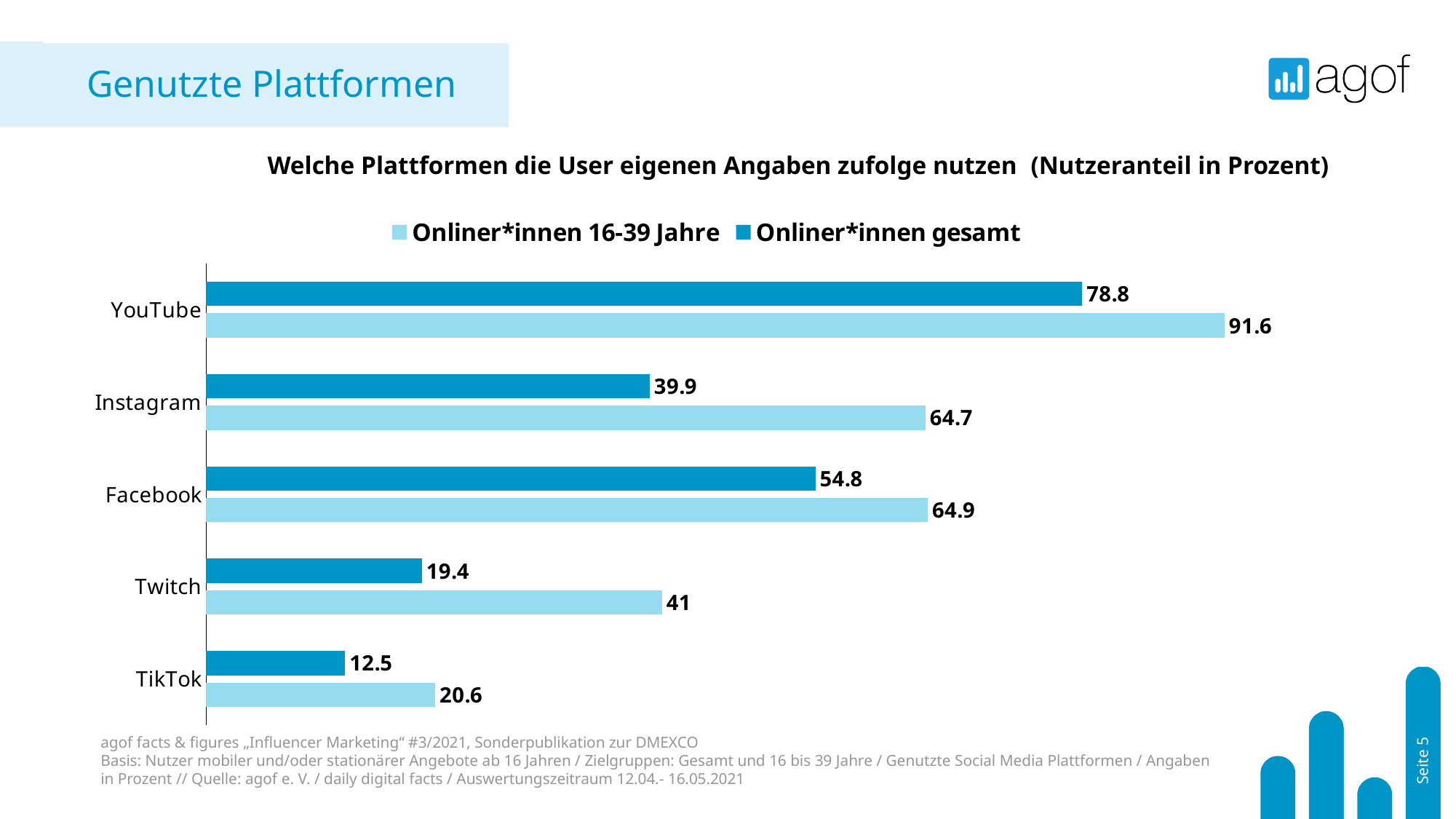
What kind of chart is shown on the slide? Bar chart What is the difference between the Onliner*innen 16-39 Jahre and Onliner*innen gesamt values for Instagram? 24.8 What is the value for YouTube in the Onliner*innen 16-39 Jahre series? 91.6 Which platform has the lowest value in the Onliner*innen 16-39 Jahre series? TikTok What is the difference between the Onliner*innen gesamt values for YouTube and TikTok? 66.3 Which series is shown in the darker blue colour? Onliner*innen gesamt How many series does the legend list? 2 How many platforms are shown on the chart? 5 Which is larger for Facebook: the Onliner*innen gesamt value or the Onliner*innen 16-39 Jahre value? Onliner*innen 16-39 Jahre What is the value for Instagram in the Onliner*innen gesamt series? 39.9 What is the value for Twitch in the Onliner*innen 16-39 Jahre series? 41 Which platform has the highest value in the Onliner*innen gesamt series? YouTube